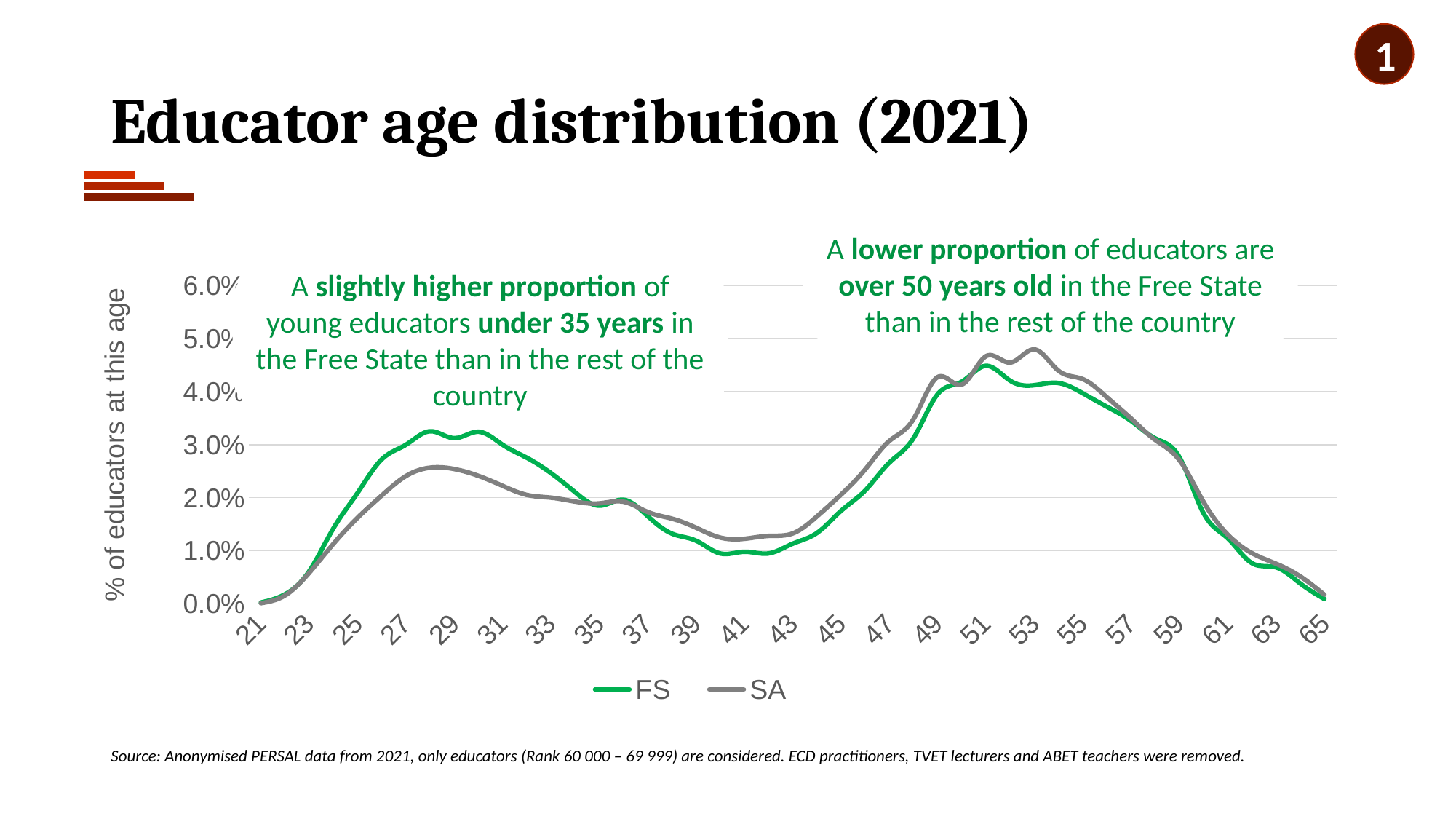
Is the value for SA at age 41 greater or less than 2.0%? less At age 53, which series has the higher value, FS or SA? SA Is the value for FS at age 51 greater or less than 4.0%? greater Which series reaches the higher peak value on the chart? SA What is the title of the chart on the slide? Educator age distribution (2021) What is the label on the vertical axis of the chart? % of educators at this age What kind of chart is shown on the slide? line chart Between ages 41 and 51, does the FS line rise or fall? rise At age 27, which series has the higher value, FS or SA? FS How many series does the legend list? 2 Is the value for FS at age 29 greater or less than 3.0%? greater